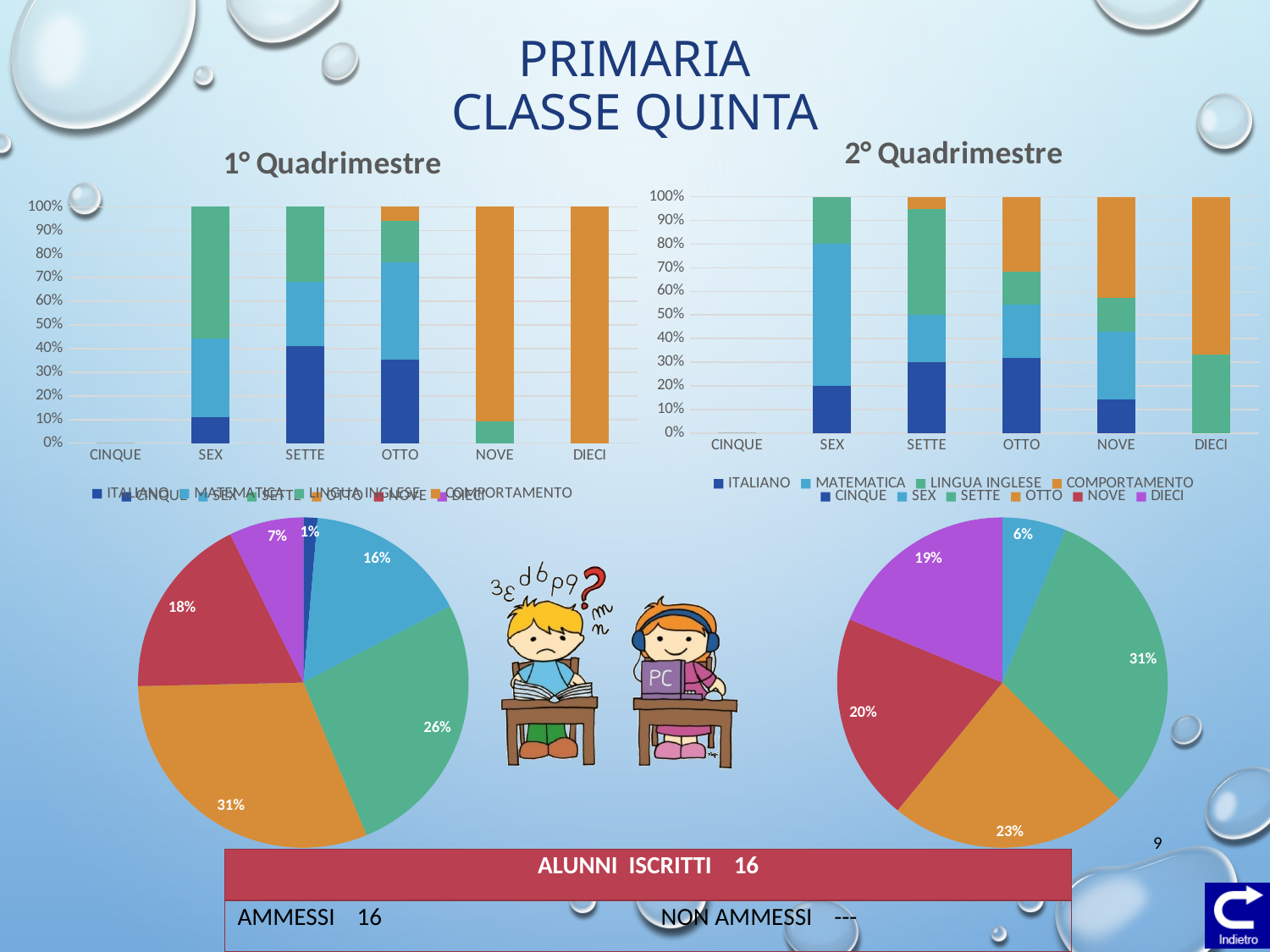
What kind of chart is the 2° Quadrimestre chart? Stacked bar chart In the left pie chart, what share does the NOVE slice have? 18% In the left pie chart, which category has the smallest slice? CINQUE In the right pie chart, which category has the largest slice? SETTE In the left pie chart, what share does the OTTO slice have? 31% How many series does the legend of the 1° Quadrimestre chart list? 4 In the right pie chart, which is larger, the OTTO slice or the NOVE slice? OTTO In the right pie chart, what share does the DIECI slice have? 19% In the 2° Quadrimestre chart, is the COMPORTAMENTO value for DIECI greater or less than 60%? greater How many categories are shown on the x axis of the 1° Quadrimestre chart? 6 In the left pie chart, what is the difference between the SETTE slice and the SEX slice? 10% In the right pie chart, what share does the SETTE slice have? 31%